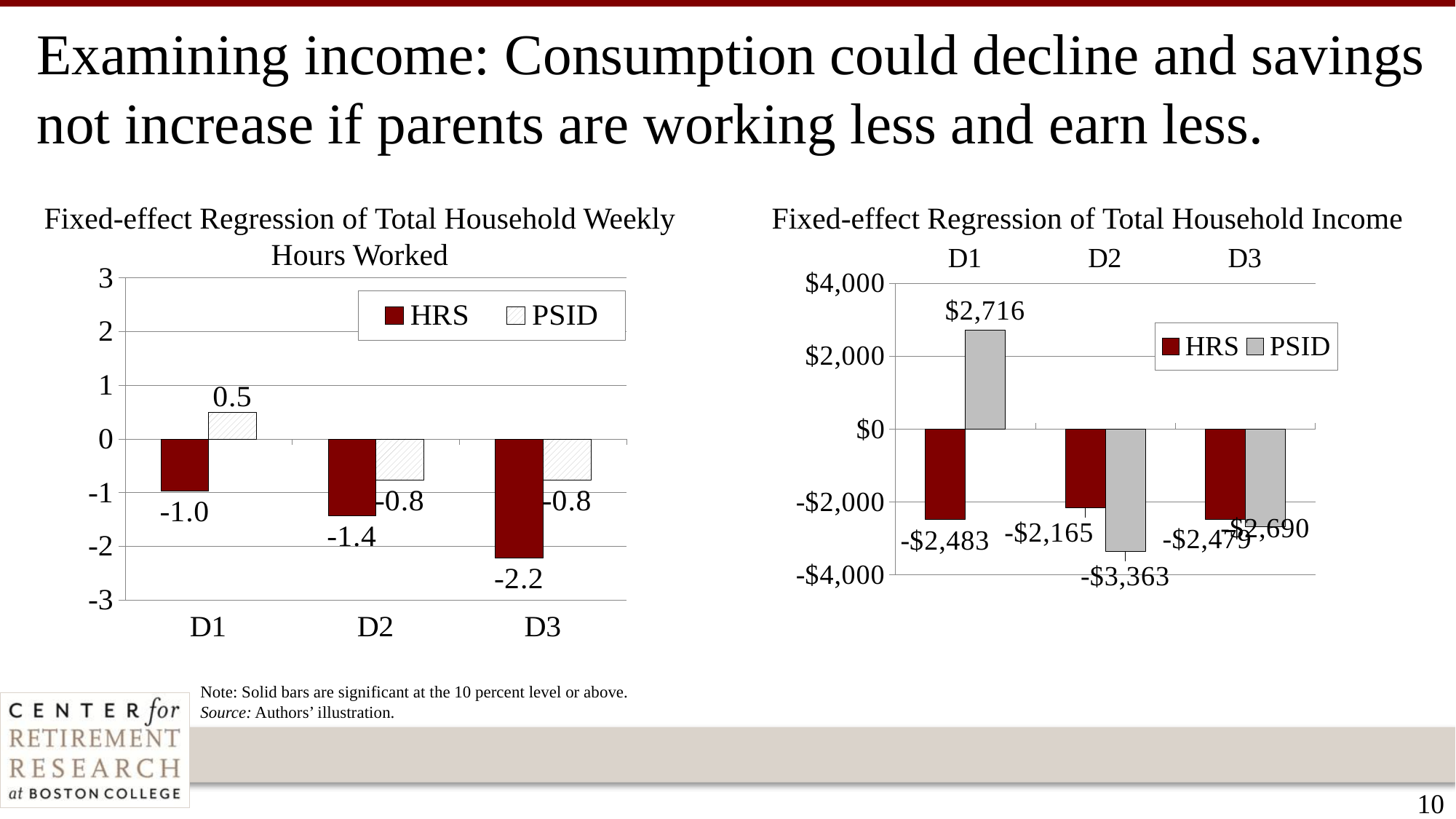
In the Total Household Income chart, is the HRS value for D2 greater or less than -$2,000? less In the Hours Worked chart, what is the PSID value for D1? 0.5 In the Total Household Income chart, what is the HRS value for D1? -$2,483 In the Total Household Income chart, what is the PSID value for D2? -$3,363 In the Total Household Income chart, what is the PSID value for D1? $2,716 In the Hours Worked chart, what is the HRS value for D3? -2.2 What type of chart is the Total Household Income chart? Bar chart In the Hours Worked chart, what is the difference between the HRS values for D1 and D3? 1.2 In the Hours Worked chart, how many series does the legend list? 2 In the Hours Worked chart, what is the HRS value for D2? -1.4 In the Total Household Income chart, which category has the lowest PSID value? D2 In the Hours Worked chart, which category has the lowest HRS value? D3